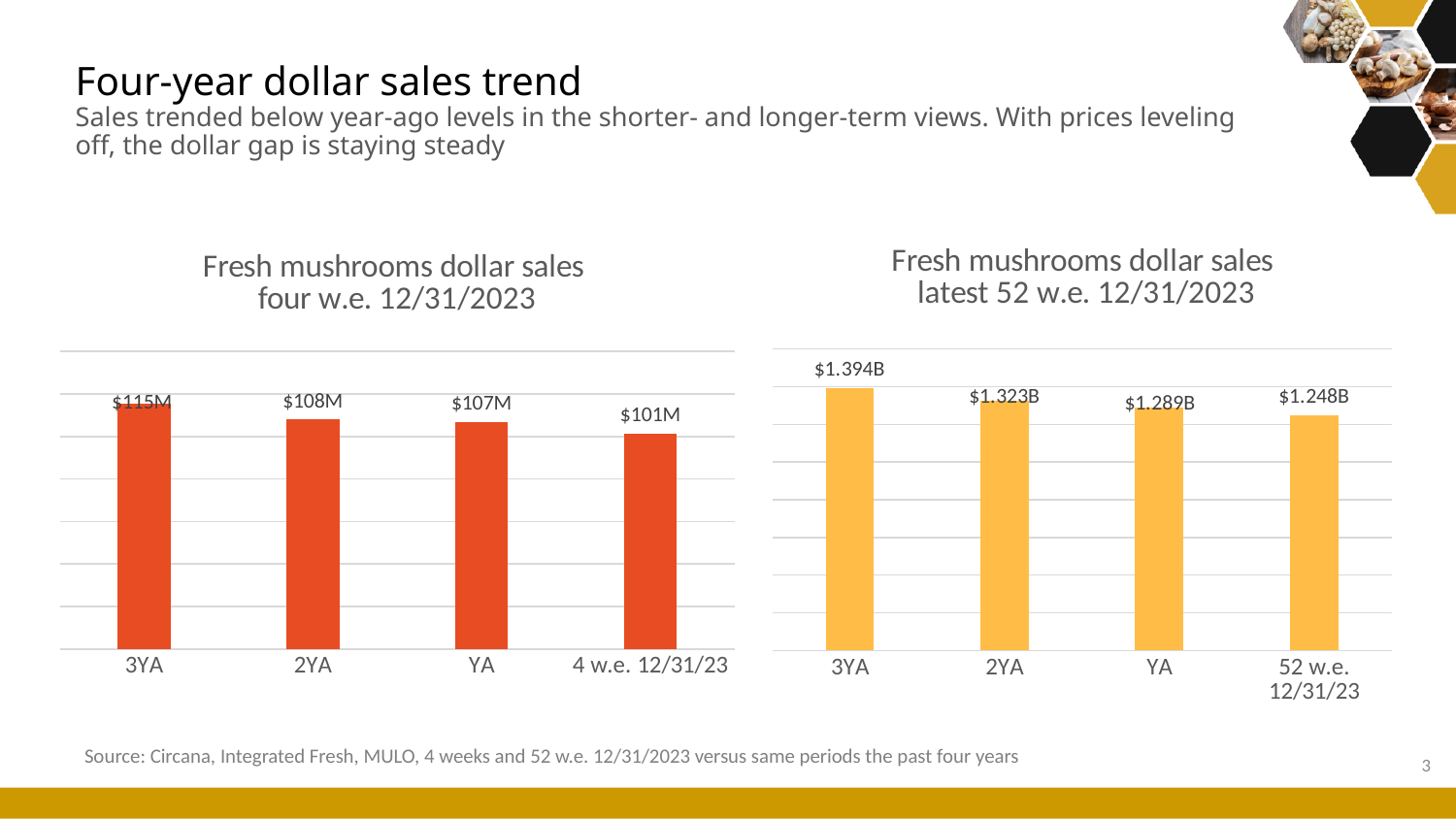
In the 'Fresh mushrooms dollar sales latest 52 w.e. 12/31/2023' chart, which period has the lowest value? 52 w.e. 12/31/23 In the 'Fresh mushrooms dollar sales latest 52 w.e. 12/31/2023' chart, what is the value for 52 w.e. 12/31/23? $1.248B In the 'Fresh mushrooms dollar sales latest 52 w.e. 12/31/2023' chart, what is the value for 2YA? $1.323B In the 'Fresh mushrooms dollar sales latest 52 w.e. 12/31/2023' chart, what is the difference between the 3YA value and the YA value? $0.105B What type of chart is the 'Fresh mushrooms dollar sales four w.e. 12/31/2023' chart? Bar chart In the 'Fresh mushrooms dollar sales four w.e. 12/31/2023' chart, what is the difference between the 3YA value and the 4 w.e. 12/31/23 value? $14M In the 'Fresh mushrooms dollar sales four w.e. 12/31/2023' chart, which period has the highest value? 3YA In the 'Fresh mushrooms dollar sales four w.e. 12/31/2023' chart, what is the value for 4 w.e. 12/31/23? $101M In the 'Fresh mushrooms dollar sales four w.e. 12/31/2023' chart, which is larger, the value for 2YA or the value for YA? 2YA In the 'Fresh mushrooms dollar sales latest 52 w.e. 12/31/2023' chart, do the values rise or fall from 3YA to 52 w.e. 12/31/23? Fall How many bars are in the 'Fresh mushrooms dollar sales latest 52 w.e. 12/31/2023' chart? 4 In the 'Fresh mushrooms dollar sales four w.e. 12/31/2023' chart, what is the value for 3YA? $115M